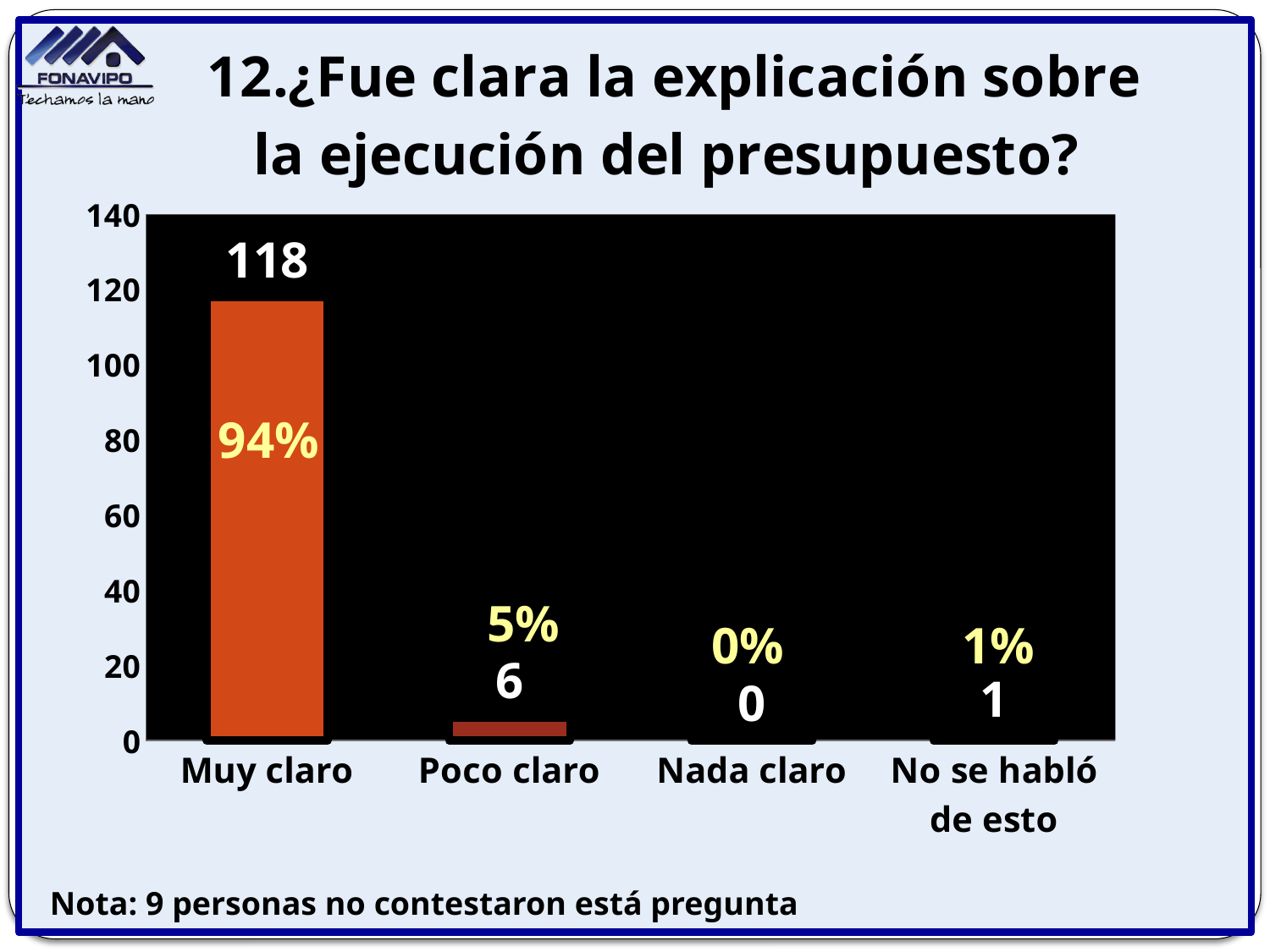
What is the difference between the values for Muy claro and Poco claro? 112 Which category has the highest value? Muy claro What is the value for Poco claro? 6 What percentage is shown for Muy claro? 94% What kind of chart is shown on the slide? Bar chart What percentage is shown for Poco claro? 5% What is the value for No se habló de esto? 1 Which is larger, the value for Poco claro or the value for No se habló de esto? Poco claro What is the value for Nada claro? 0 What is the value for Muy claro? 118 How many categories are shown on the x axis? 4 Which category has the lowest value? Nada claro